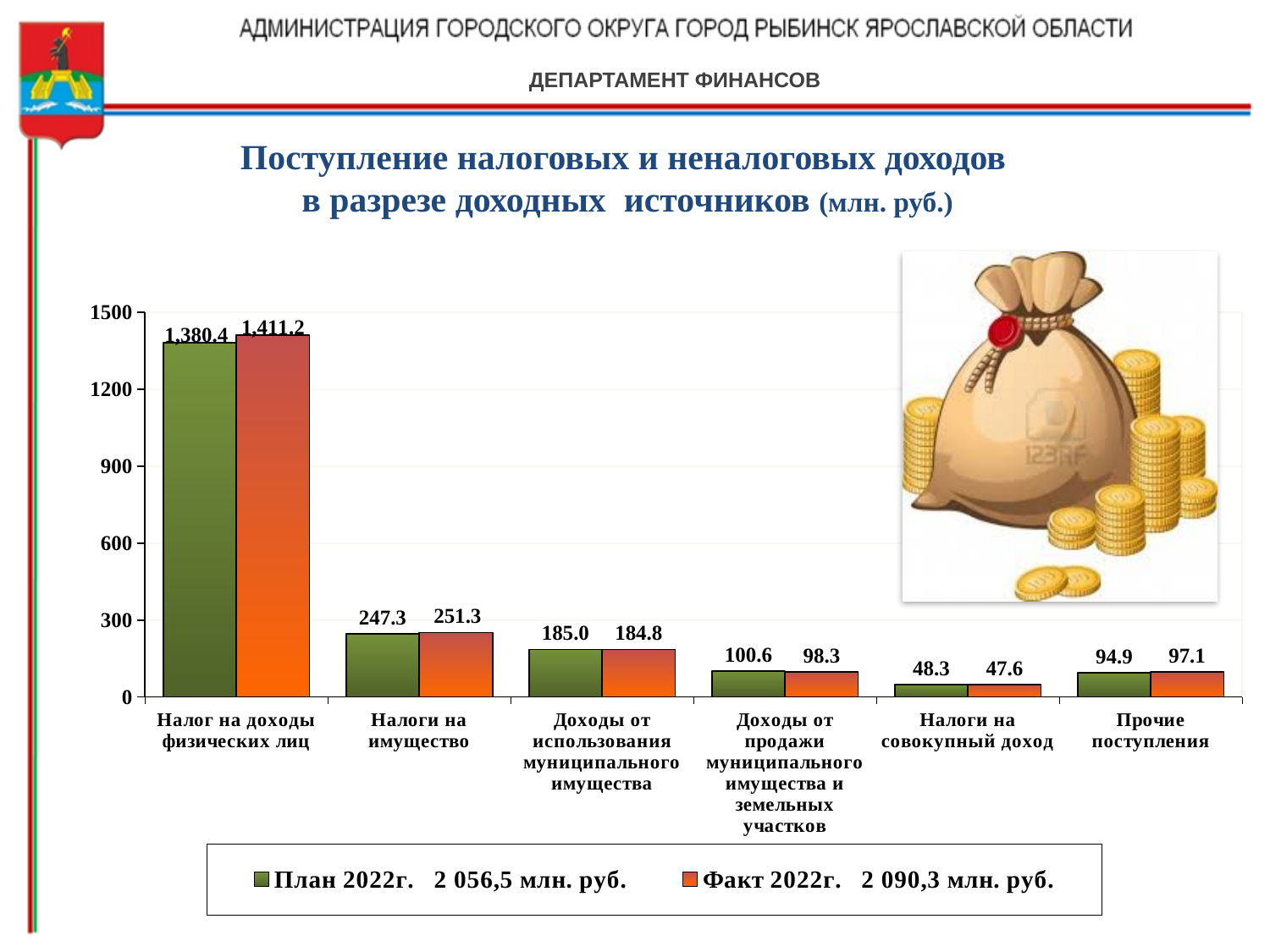
Which category has the lowest Факт 2022г. value? Налоги на совокупный доход Which category has the highest План 2022г. value? Налог на доходы физических лиц How many series does the legend list? 2 What is the План 2022г. value for Прочие поступления? 94.9 What is the Факт 2022г. value for Доходы от продажи муниципального имущества и земельных участков? 98.3 What is the План 2022г. value for Налоги на имущество? 247.3 What is the difference between the Факт 2022г. and План 2022г. values for Налог на доходы физических лиц? 30.8 What total amount is shown in the legend for Факт 2022г.? 2 090,3 млн. руб. Which is larger for Доходы от использования муниципального имущества: the План 2022г. value or the Факт 2022г. value? План 2022г. What is the Факт 2022г. value for Налог на доходы физических лиц? 1,411.2 How many categories are shown on the x axis of the chart? 6 What kind of chart is shown on the slide? Bar chart